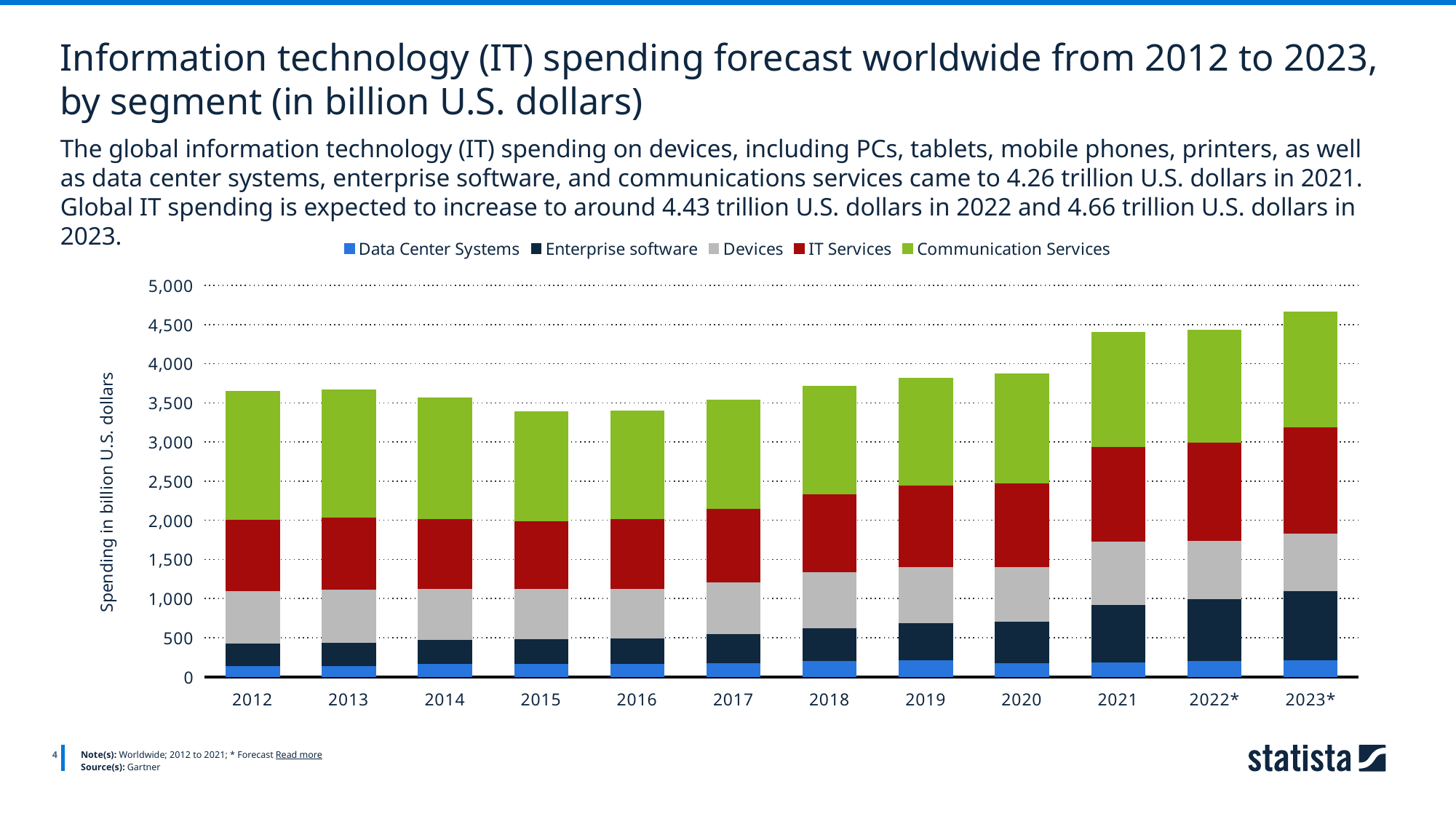
How many years are shown along the x axis? 12 Is the total IT spending for 2023* greater or less than 4,500? greater Is the total IT spending for 2021 greater or less than 4,000? greater Is the total IT spending for 2012 greater or less than 4,000? less Which year has the larger total IT spending, 2020 or 2021? 2021 What kind of chart is shown on the slide? Stacked bar chart What is the label on the y axis? Spending in billion U.S. dollars Does total IT spending rise or fall between 2012 and 2023*? rise Which year has the highest total IT spending? 2023* Which series is shown in green in the legend? Communication Services How many series does the legend list? 5